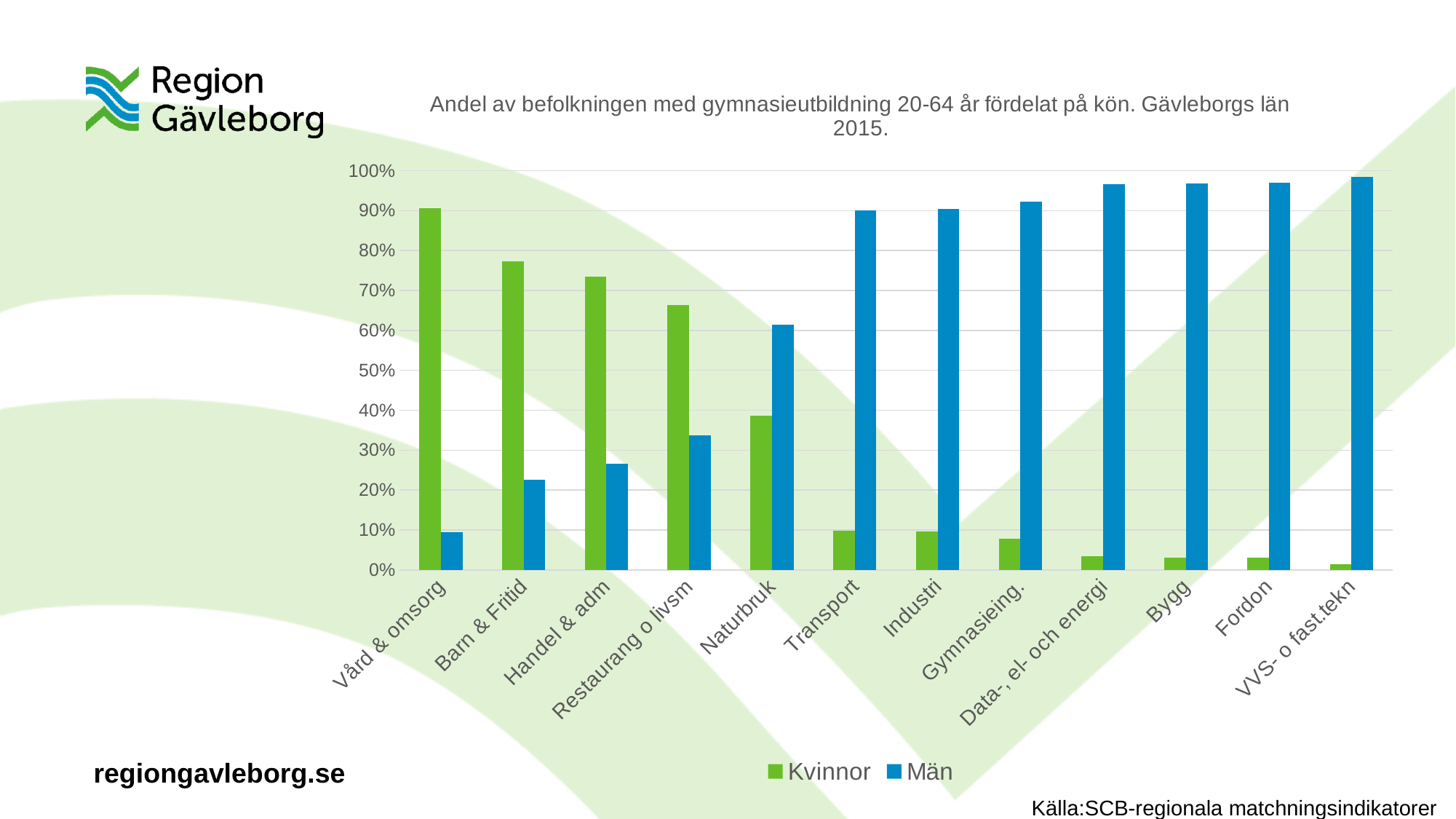
Do the values for Kvinnor rise or fall from left to right along the x axis? fall What kind of chart is shown on the slide? bar chart How many categories are shown on the x axis? 12 Which category has the lowest value for Män? Vård & omsorg Is the value for Kvinnor in Vård & omsorg greater or less than 80%? greater What colour are the bars for Män? blue For Naturbruk, which is larger: the value for Kvinnor or the value for Män? Män Which category has the lowest value for Kvinnor? VVS- o fast.tekn Is the value for Kvinnor in Handel & adm greater or less than 70%? greater How many series does the legend list? 2 Is the value for Män in Restaurang o livsm greater or less than 40%? less Which category has the highest value for Kvinnor? Vård & omsorg